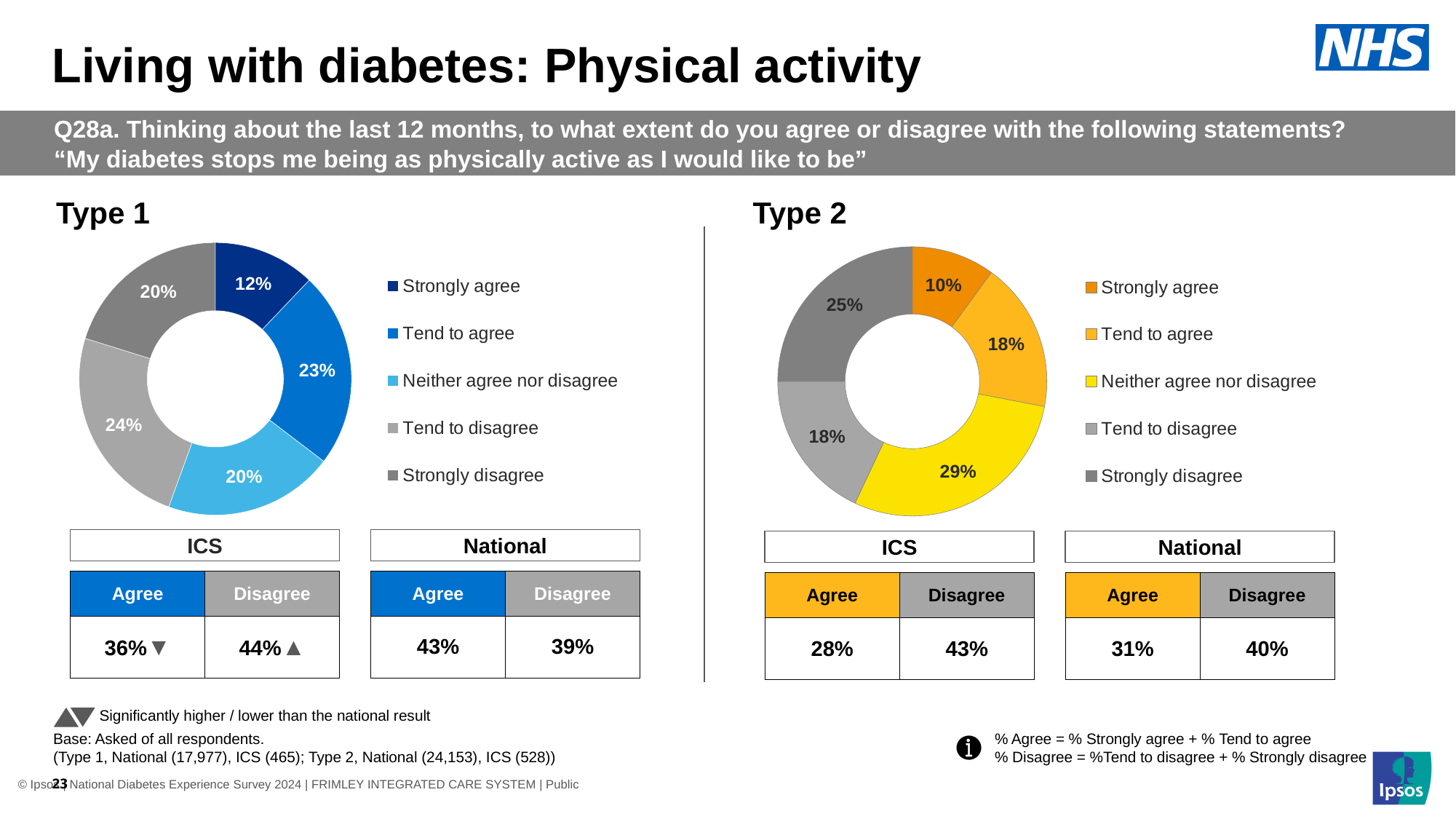
In the Type 1 chart, what percentage of respondents said they tend to disagree? 24% In the Type 1 chart, which response category has the largest share? Tend to disagree What type of chart is used to show the Type 2 results? Donut (pie) chart In the Type 1 chart, what percentage of respondents said they strongly agree? 12% How many response categories does the legend of the Type 1 chart list? 5 In the Type 2 chart, which response category has the largest share? Neither agree nor disagree In the Type 2 chart, what percentage of respondents said they strongly disagree? 25% In the Type 2 chart, what colour represents Neither agree nor disagree? Yellow In the Type 1 chart, what is the difference between the Tend to agree share and the Strongly agree share? 11 percentage points In the Type 2 chart, what percentage of respondents said they neither agree nor disagree? 29% In the Type 2 chart, which is larger: the Strongly disagree share or the Tend to agree share? Strongly disagree In the Type 2 chart, which response category has the smallest share? Strongly agree